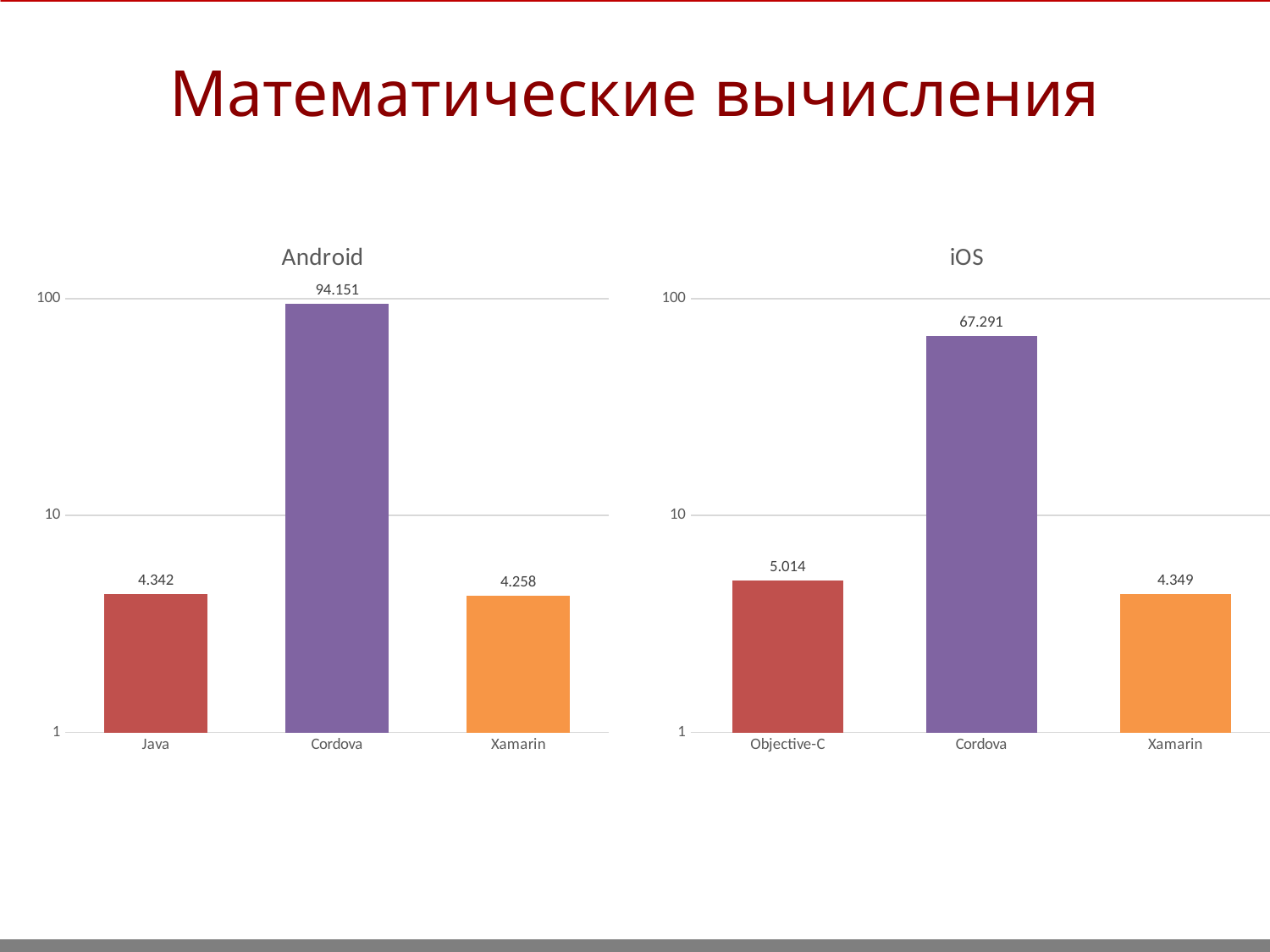
In the iOS chart, what is the value for Xamarin? 4.349 In the Android chart, which category has the lowest value? Xamarin In the iOS chart, which is larger, the value for Objective-C or the value for Xamarin? Objective-C In the Android chart, what is the difference between the values for Cordova and Java? 89.809 In the Android chart, is the value for Java greater or less than 10? less How many categories are shown in the iOS chart? 3 In the Android chart, what is the value for Cordova? 94.151 In the Android chart, which category has the highest value? Cordova In the iOS chart, what is the difference between the values for Objective-C and Xamarin? 0.665 In the iOS chart, which category has the lowest value? Xamarin In the iOS chart, what is the value for Objective-C? 5.014 What kind of chart is the Android chart? bar chart